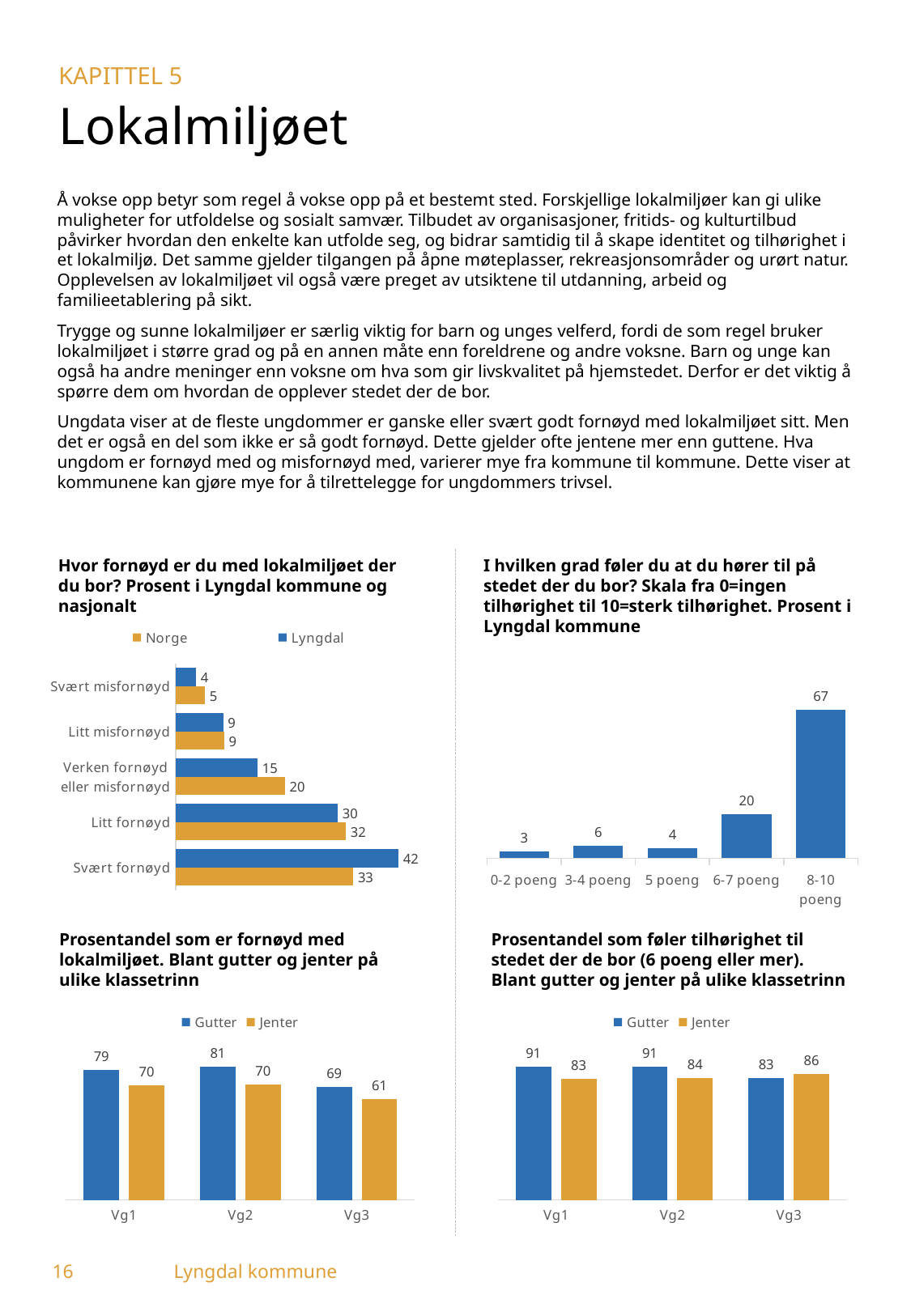
In the top-left chart (Hvor fornøyd er du med lokalmiljøet der du bor?), what is the Lyngdal value for Svært fornøyd? 42 In the bottom-left chart (Prosentandel som er fornøyd med lokalmiljøet), what is the difference between Gutter and Jenter for Vg1? 9 In the bottom-left chart (Prosentandel som er fornøyd med lokalmiljøet), what is the Gutter value for Vg2? 81 In the bottom-right chart (Prosentandel som føler tilhørighet til stedet der de bor), which is larger for Vg3, Gutter or Jenter? Jenter In the top-right chart (I hvilken grad føler du at du hører til på stedet der du bor?), which category has the lowest value? 0-2 poeng What kind of chart is the bottom-right chart (Prosentandel som føler tilhørighet til stedet der de bor)? Bar chart In the top-right chart (I hvilken grad føler du at du hører til på stedet der du bor?), which category has the highest value? 8-10 poeng In the top-left chart (Hvor fornøyd er du med lokalmiljøet der du bor?), how many series does the legend list? 2 In the top-left chart (Hvor fornøyd er du med lokalmiljøet der du bor?), what is the Norge value for Verken fornøyd eller misfornøyd? 20 In the top-right chart (I hvilken grad føler du at du hører til på stedet der du bor?), what is the value for 6-7 poeng? 20 In the top-left chart (Hvor fornøyd er du med lokalmiljøet der du bor?), what is the difference between the Lyngdal and Norge values for Svært fornøyd? 9 In the top-right chart (I hvilken grad føler du at du hører til på stedet der du bor?), how many categories are shown on the x axis? 5